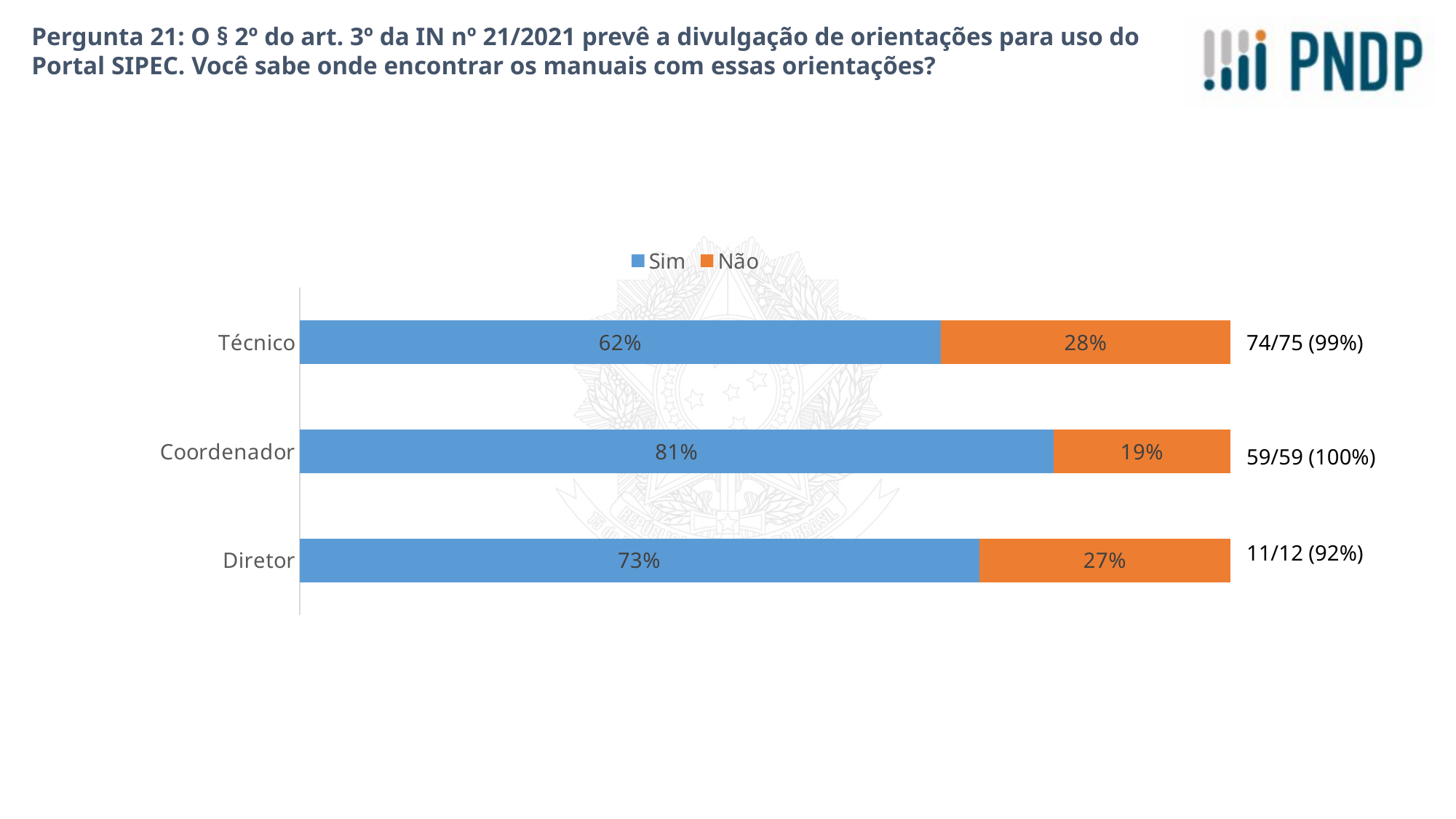
What is the 'Sim' value for Diretor? 73% How many categories are shown in the chart? 3 What is the 'Sim' value for Coordenador? 81% How many series does the legend list? 2 Which category has the lowest 'Não' value? Coordenador What is the 'Não' value for Técnico? 28% What is the difference between the 'Sim' values for Coordenador and Técnico? 19% Which category has the highest 'Sim' value? Coordenador What is the 'Não' value for Diretor? 27% What kind of chart is shown on the slide? Stacked bar chart Which category has the lowest 'Sim' value? Técnico Which is larger, the 'Não' value for Diretor or the 'Não' value for Coordenador? Diretor